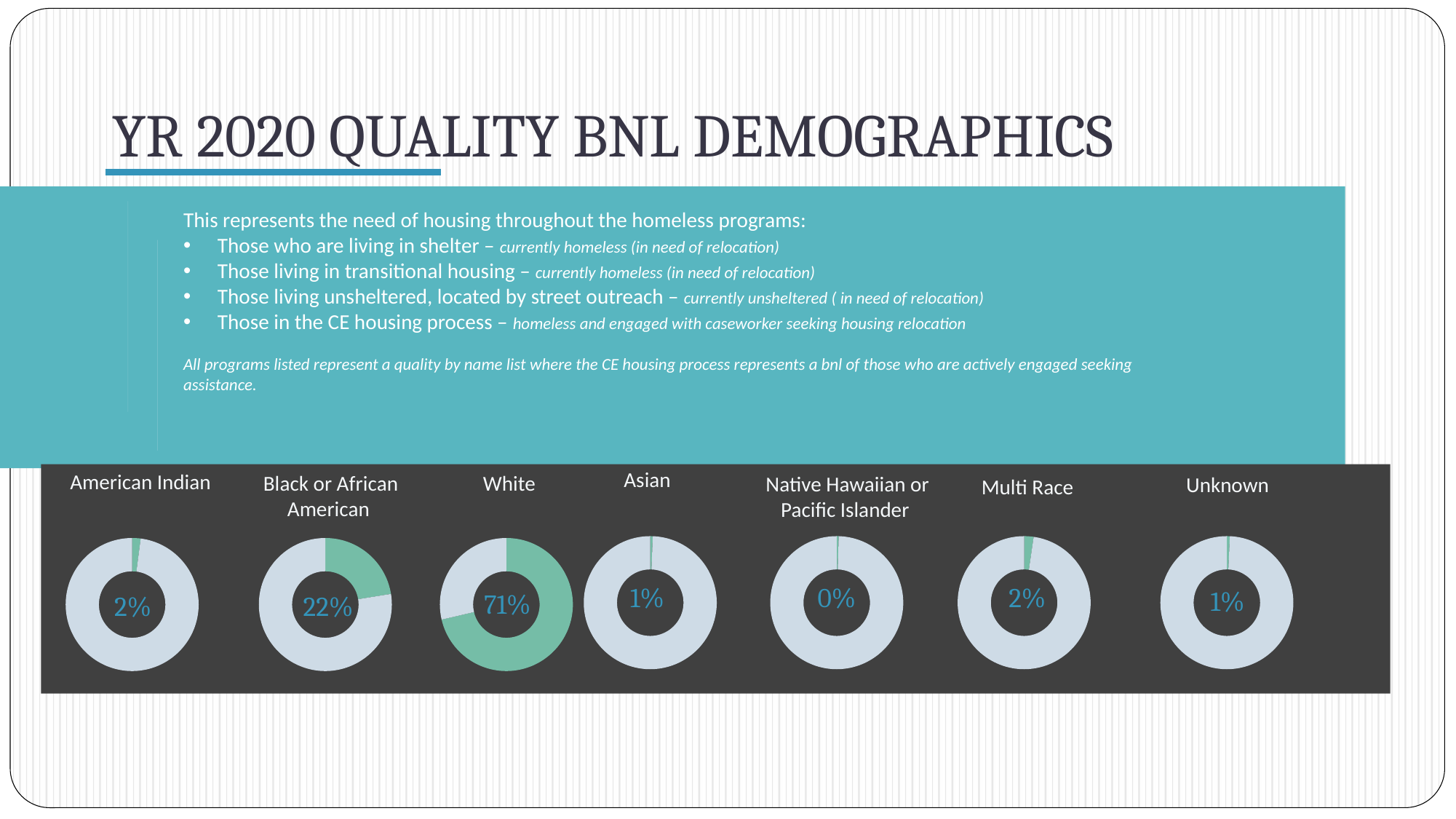
What percentage is shown in the White donut chart? 71% What is the difference between the White percentage and the Black or African American percentage? 49% What percentage is shown in the Multi Race donut chart? 2% What percentage is shown in the Asian donut chart? 1% What kind of chart is used to show each demographic group's percentage? Donut (pie) chart What percentage is shown in the Black or African American donut chart? 22% What percentage is shown in the American Indian donut chart? 2% What percentage is shown in the Unknown donut chart? 1% What percentage is shown in the Native Hawaiian or Pacific Islander donut chart? 0% How many donut charts are shown on the slide? 7 Which demographic group has the lowest percentage across the donut charts? Native Hawaiian or Pacific Islander Which demographic group has the highest percentage across the donut charts? White